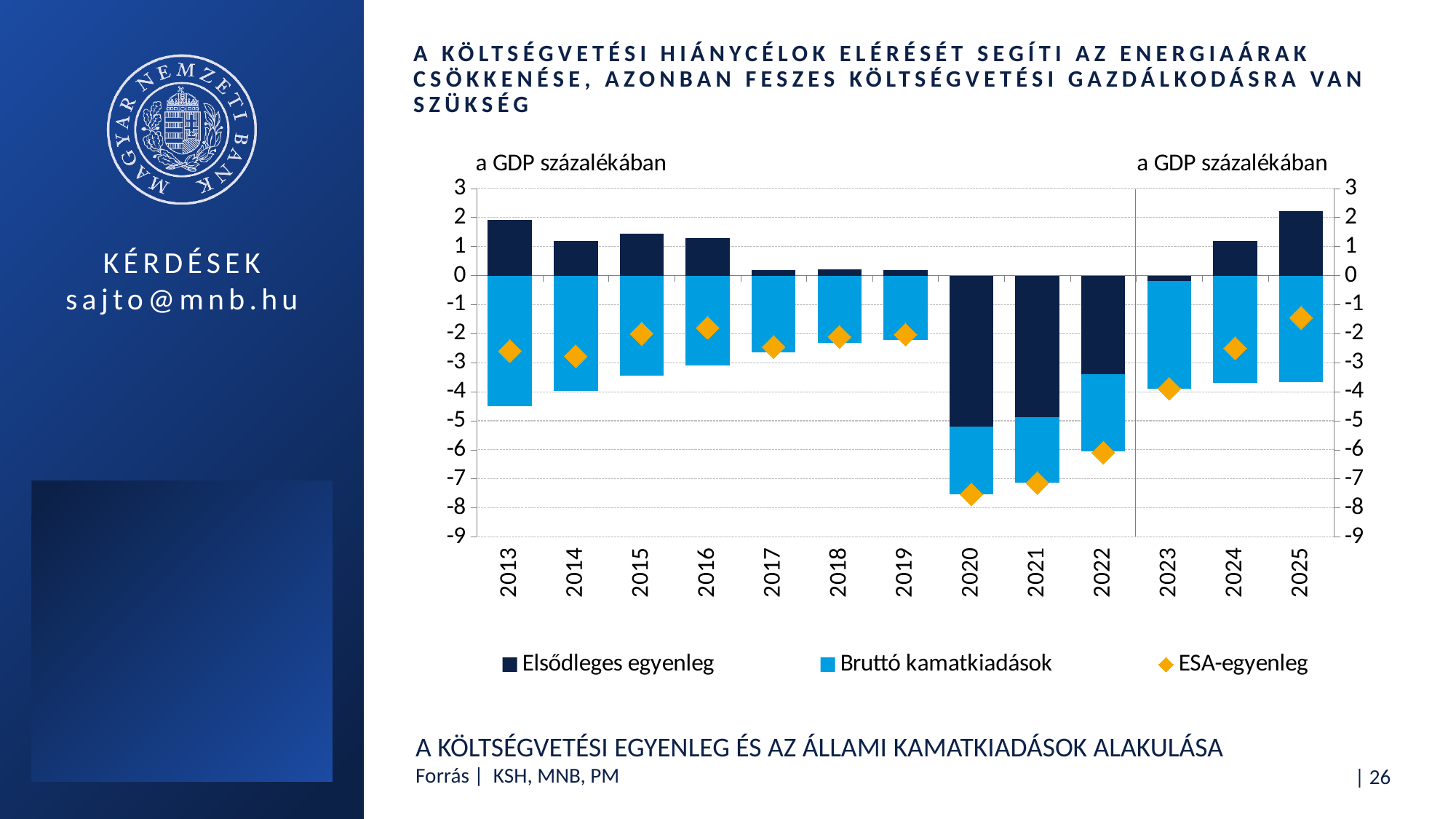
Is the ESA-egyenleg value for 2025 greater or less than -2? greater Is the ESA-egyenleg value for 2020 greater or less than -7? less Which year has the larger ESA-egyenleg value, 2017 or 2020? 2017 Is the Elsődleges egyenleg value for 2013 greater or less than 1? greater What kind of chart is used to show Elsődleges egyenleg and Bruttó kamatkiadások? Stacked bar chart How many years are shown on the x axis of the chart? 13 Which year has the larger Elsődleges egyenleg value, 2013 or 2017? 2013 Does the ESA-egyenleg rise or fall from 2020 to 2025? rise How many series does the chart legend list? 3 What unit is given in the axis title of the chart? a GDP százalékában